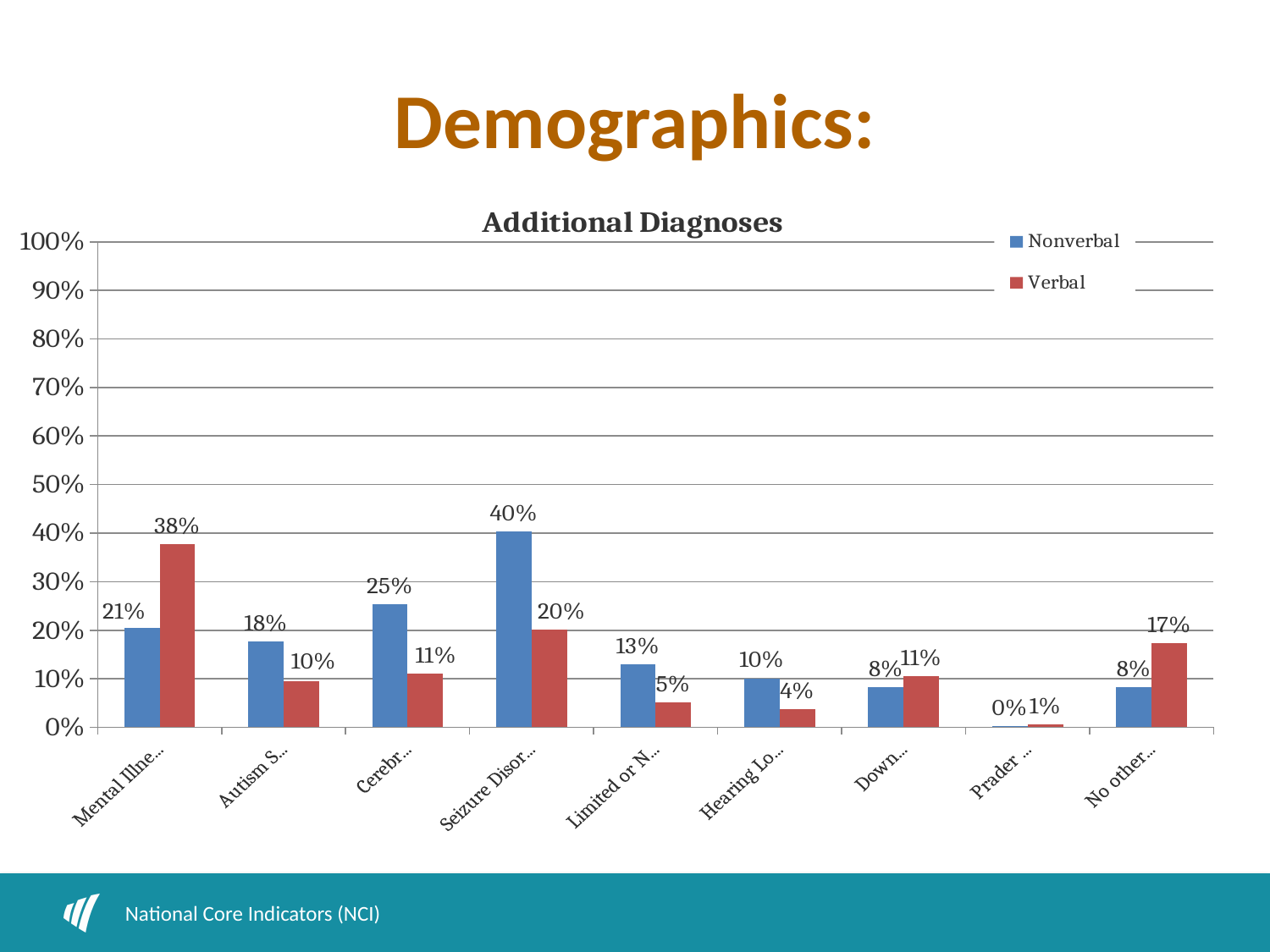
Which category has the highest Nonverbal value in the Additional Diagnoses chart? Seizure Disor... What type of chart is used to show Additional Diagnoses on this slide? Bar chart In the Additional Diagnoses chart, what is the Verbal value for the category labelled "Mental Illne..."? 38% How many series does the legend of the Additional Diagnoses chart list? 2 In the Additional Diagnoses chart, which series has the larger value for the category labelled "Down...", Nonverbal or Verbal? Verbal In the Additional Diagnoses chart, what is the difference between the Nonverbal and Verbal values for the category labelled "Seizure Disor..."? 20% In the Additional Diagnoses chart, how much higher is the Verbal value than the Nonverbal value for the category labelled "Mental Illne..."? 17% How many categories are shown on the x axis of the Additional Diagnoses chart? 9 In the Additional Diagnoses chart, what is the Verbal value for the category labelled "No other..."? 17% Which category has the lowest Verbal value in the Additional Diagnoses chart? Prader ... In the Additional Diagnoses chart, which series has the larger value for the category labelled "Cerebr...", Nonverbal or Verbal? Nonverbal In the Additional Diagnoses chart, what is the Nonverbal value for the category labelled "Seizure Disor..."? 40%